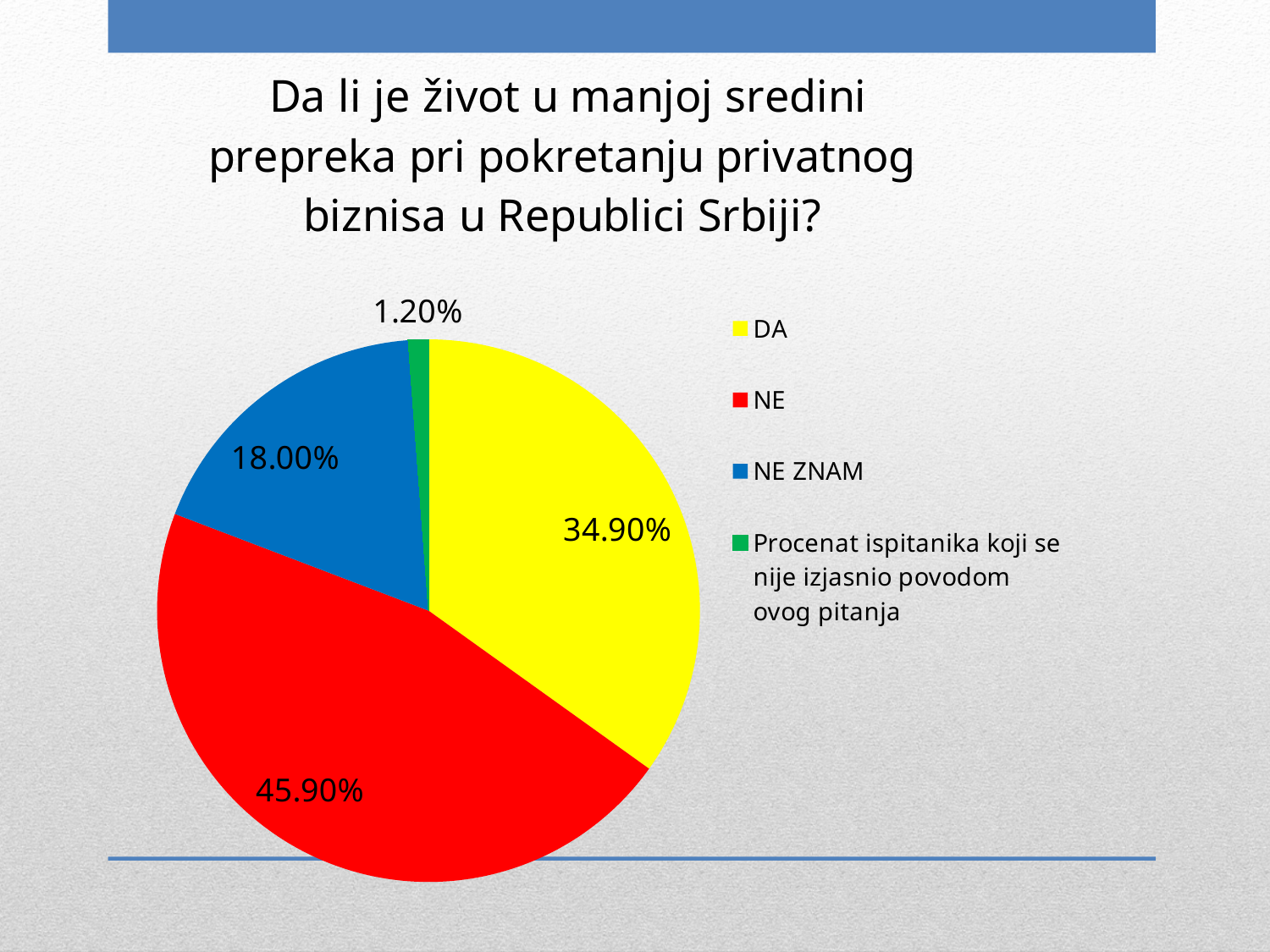
What colour represents the NE ZNAM category? blue What kind of chart is shown on the slide? pie chart How many categories does the legend list? 4 What is the difference in percentage points between NE and DA? 11 percentage points Which category has the largest share of the pie? NE Which category has the smallest share of the pie? Procenat ispitanika koji se nije izjasnio povodom ovog pitanja Which is larger, the share for DA or the share for NE ZNAM? DA What percentage of respondents did not answer the question (Procenat ispitanika koji se nije izjasnio povodom ovog pitanja)? 1.20% What percentage of respondents answered NE ZNAM? 18.00% What percentage of respondents answered DA? 34.90% What colour represents the DA category? yellow What percentage of respondents answered NE? 45.90%